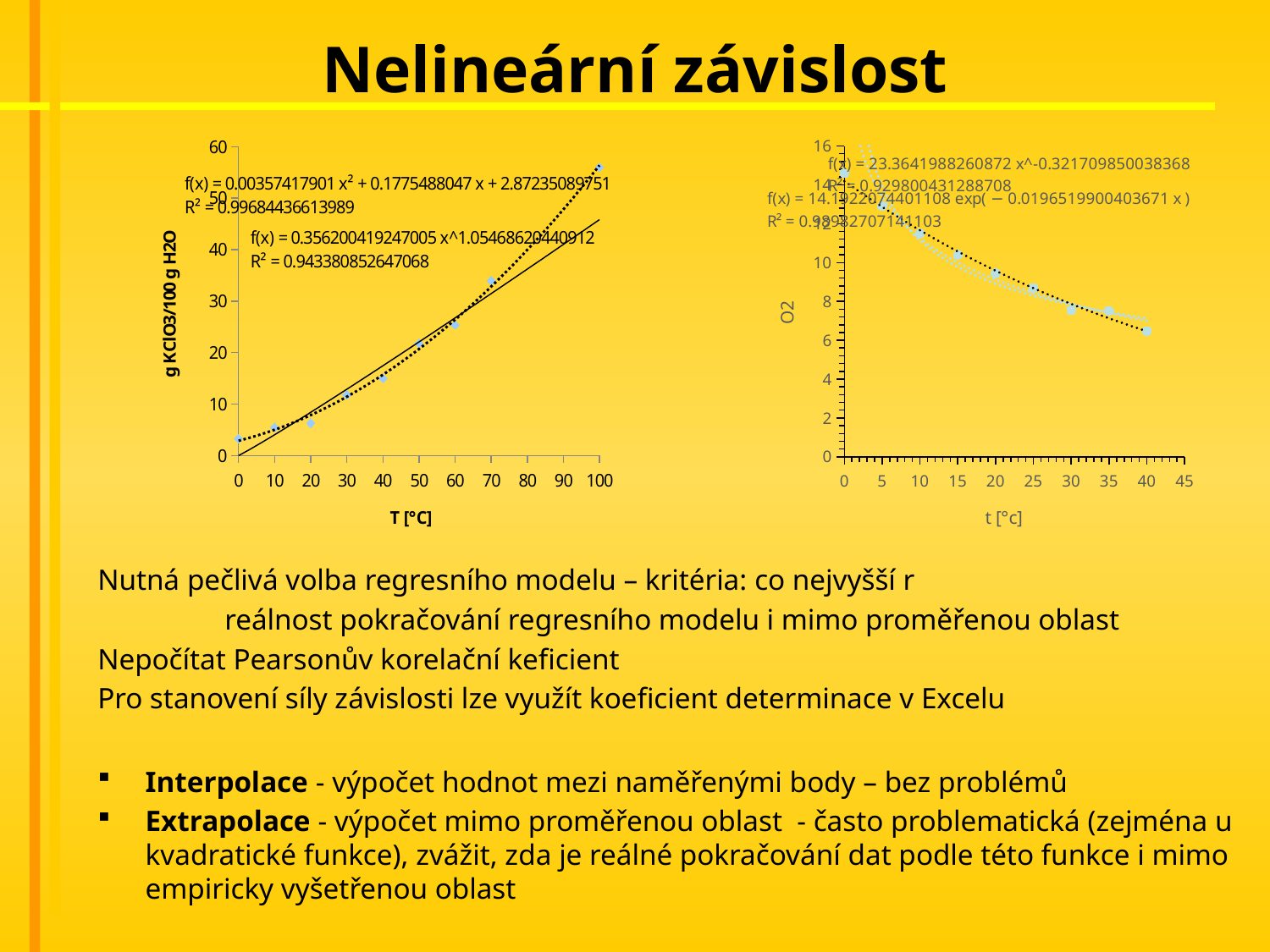
In the right chart, at which t [°c] value is the plotted O2 point lowest? 40 In the left chart, is the plotted value at T = 100 °C greater or less than 50? greater In the right chart, do the plotted O2 values rise or fall as t [°c] increases? fall In the right chart, is the plotted O2 value at t = 40 greater or less than 8? less In the left chart, at which T [°C] value is the plotted point lowest? 0 What kind of chart is the left chart (g KClO3/100 g H2O vs T [°C])? scatter chart In the right chart, at which t [°c] value is the plotted O2 point highest? 0 In the right chart, is the plotted O2 value at t = 0 greater or less than 12? greater In the left chart, do the plotted values rise or fall as T [°C] increases? rise What kind of chart is the right chart (O2 vs t [°c])? scatter chart What is the x-axis title of the left chart? T [°C] In the left chart, at which T [°C] value is the plotted point highest? 100